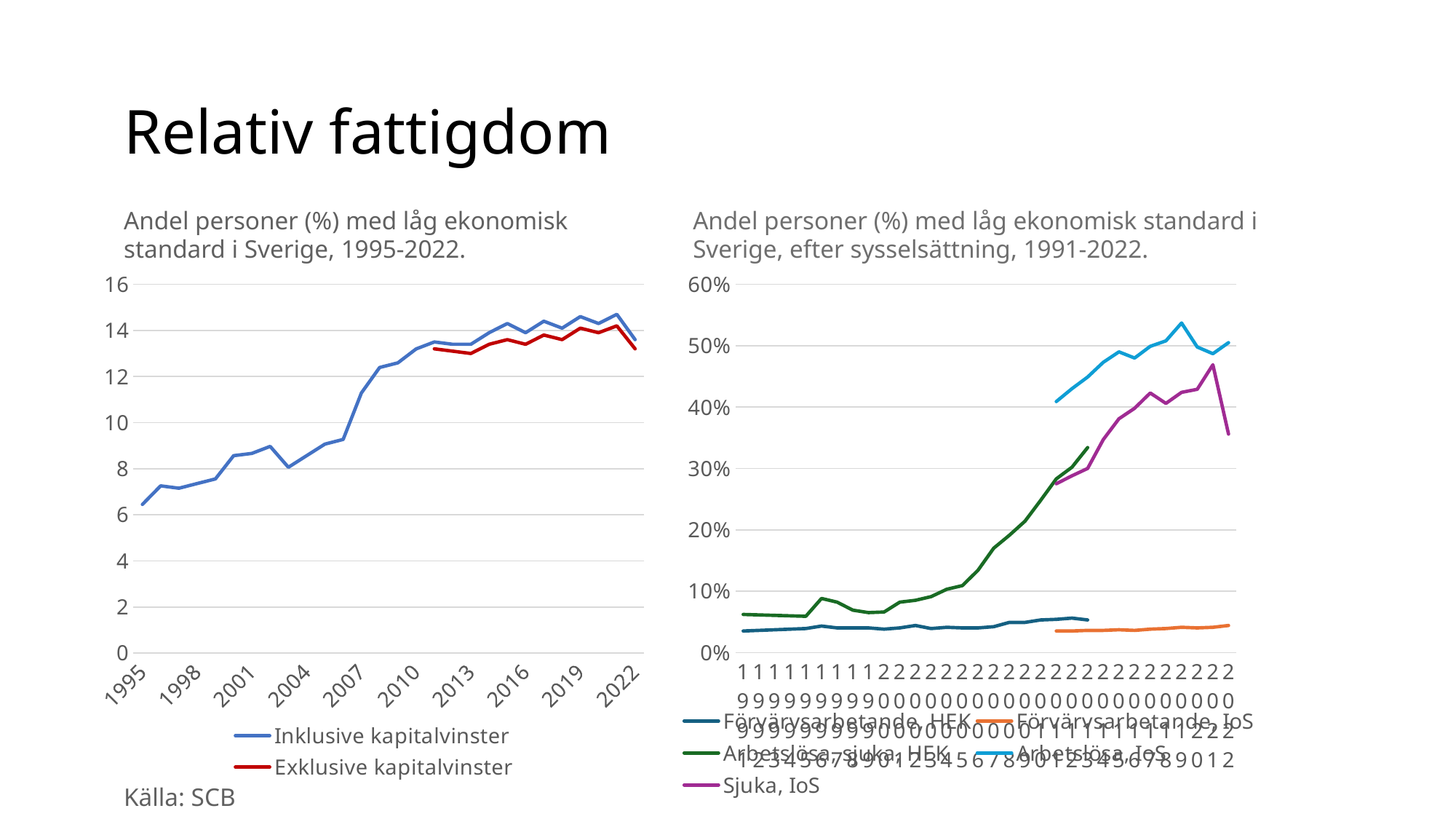
In the right chart, which series reaches the highest value? Arbetslösa, IoS In the right chart, is the value for 'Förvärvsarbetande, IoS' in 2022 greater or less than 10%? less In the right chart, is the final value of 'Sjuka, IoS' greater or less than 40%? less In the left chart, is the value for 'Inklusive kapitalvinster' in 1995 greater or less than 8? less What kind of chart is the left chart, 'Andel personer (%) med låg ekonomisk standard i Sverige, 1995-2022'? Line chart What source is cited at the bottom of the slide? Källa: SCB How many series does the legend of the left chart list? 2 How many series does the legend of the right chart, 'efter sysselsättning, 1991-2022', list? 5 In the left chart, which series is higher in 2019, 'Inklusive kapitalvinster' or 'Exklusive kapitalvinster'? Inklusive kapitalvinster In the right chart, does the 'Arbetslösa-sjuka, HEK' series overall rise or fall over its period? Rise In the left chart, does the 'Inklusive kapitalvinster' series overall rise or fall from 1995 to 2022? Rise